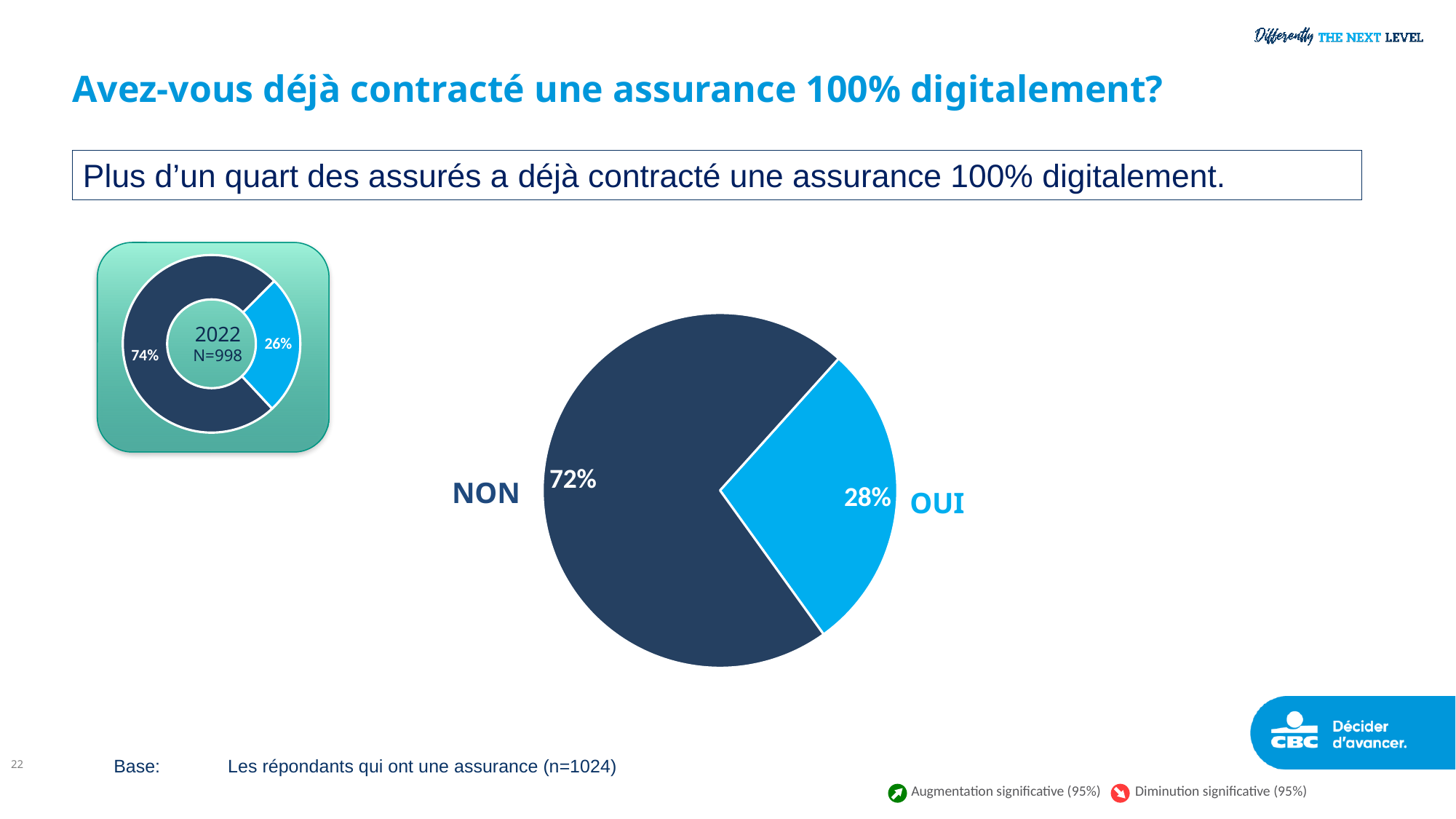
In the large pie chart, which is larger, OUI or NON? NON What kind of chart is the large chart in the centre of the slide? Pie chart In the large pie chart, what percentage is shown for OUI? 28% In the small donut chart on the left, what percentage is shown in the dark blue segment? 74% In the small donut chart on the left, what percentage is shown in the light blue segment? 26% In the large pie chart, what is the difference in percentage points between NON and OUI? 44 How many slices does the large pie chart have? 2 In the large pie chart, what colour is the OUI slice? Light blue What year and sample size are shown in the centre of the small donut chart on the left? 2022, N=998 In the large pie chart, which slice is the smallest? OUI In the large pie chart, what percentage is shown for NON? 72% In the large pie chart, which slice is the largest? NON